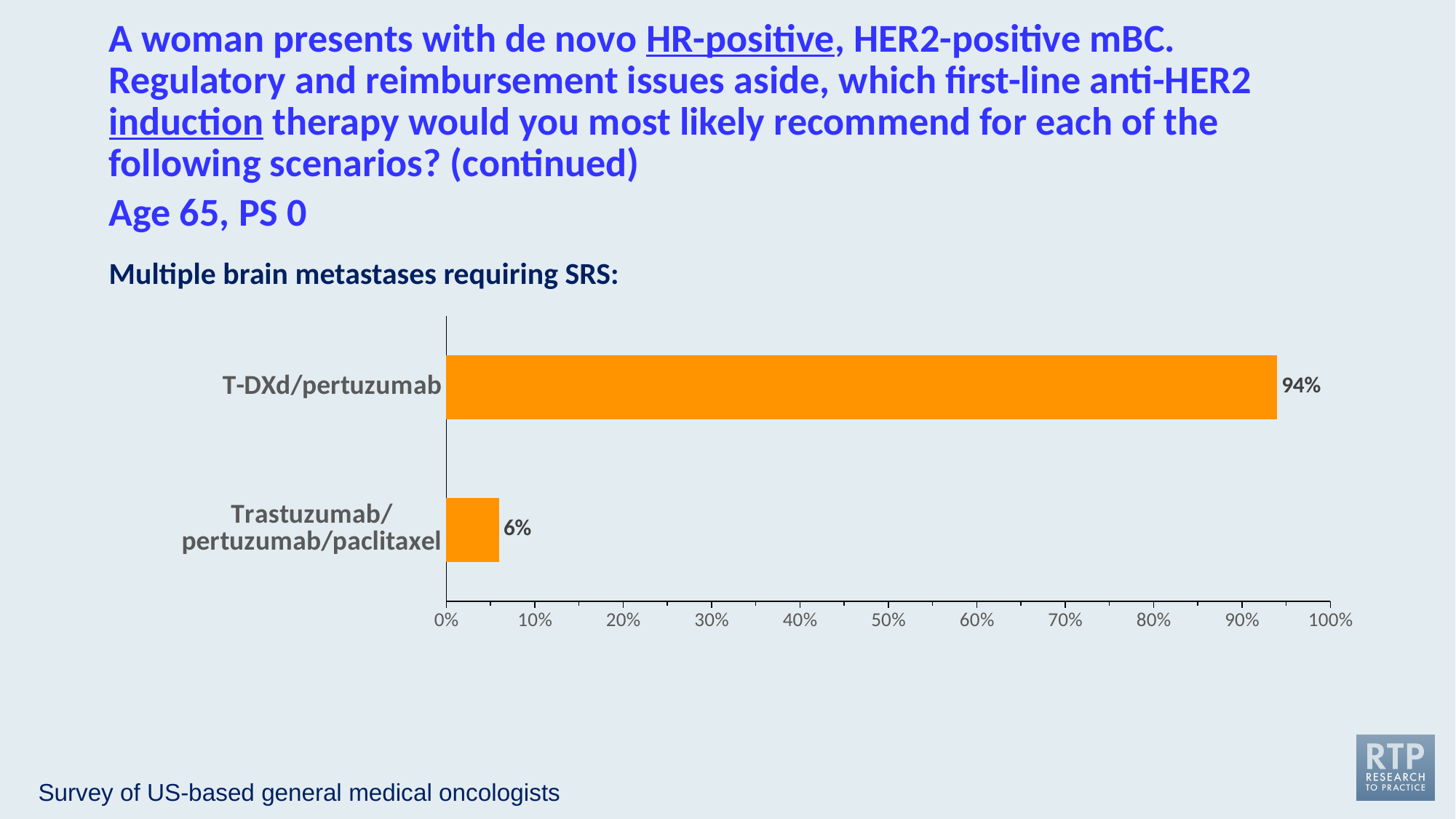
Is the value for T-DXd/pertuzumab greater or less than 90%? greater What percentage of respondents chose T-DXd/pertuzumab? 94% What percentage of respondents chose Trastuzumab/pertuzumab/paclitaxel? 6% What is the total of the two percentages shown in the chart? 100% What clinical scenario does the chart describe, as stated in the heading above it? Multiple brain metastases requiring SRS Which received a larger share of responses, T-DXd/pertuzumab or Trastuzumab/pertuzumab/paclitaxel? T-DXd/pertuzumab How many treatment options are shown in the chart? 2 What type of chart is shown on the slide? Bar chart What is the difference in percentage points between T-DXd/pertuzumab and Trastuzumab/pertuzumab/paclitaxel? 88 percentage points Which option received the highest percentage of responses? T-DXd/pertuzumab Which option received the lowest percentage of responses? Trastuzumab/pertuzumab/paclitaxel Is the value for Trastuzumab/pertuzumab/paclitaxel greater or less than 10%? less